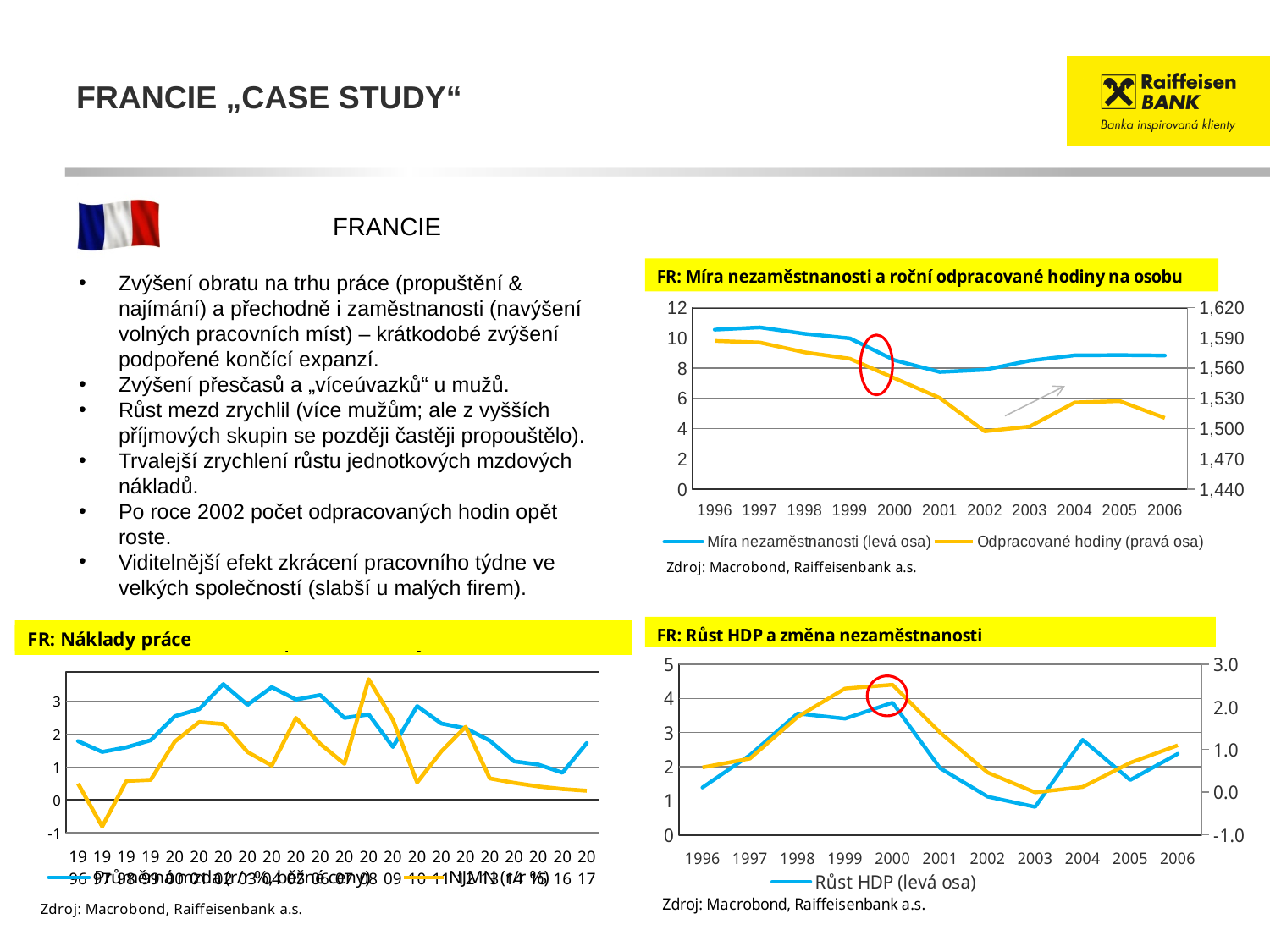
In the 'FR: Míra nezaměstnanosti a roční odpracované hodiny na osobu' chart, does Míra nezaměstnanosti rise or fall between 1996 and 2001? fall In the 'FR: Míra nezaměstnanosti a roční odpracované hodiny na osobu' chart, which series is plotted on the right axis? Odpracované hodiny (pravá osa) How many series does the legend of the 'FR: Míra nezaměstnanosti a roční odpracované hodiny na osobu' chart list? 2 In the 'FR: Růst HDP a změna nezaměstnanosti' chart, is the value of Růst HDP in 2000 greater or less than 3? greater What kind of chart is the 'FR: Míra nezaměstnanosti a roční odpracované hodiny na osobu' chart? line chart What kind of chart is the 'FR: Růst HDP a změna nezaměstnanosti' chart? line chart In the 'FR: Růst HDP a změna nezaměstnanosti' chart, does Růst HDP rise or fall between 2000 and 2003? fall In the 'FR: Míra nezaměstnanosti a roční odpracované hodiny na osobu' chart, how many years are shown on the x axis? 11 In the 'FR: Míra nezaměstnanosti a roční odpracované hodiny na osobu' chart, does Odpracované hodiny rise or fall between 2002 and 2005? rise In the 'FR: Náklady práce' chart, how many years are shown on the x axis? 22 In the 'FR: Míra nezaměstnanosti a roční odpracované hodiny na osobu' chart, is the value of Odpracované hodiny in 2002 greater or less than 1,530? less In the 'FR: Míra nezaměstnanosti a roční odpracované hodiny na osobu' chart, is the value of Míra nezaměstnanosti in 1996 greater or less than 10? greater